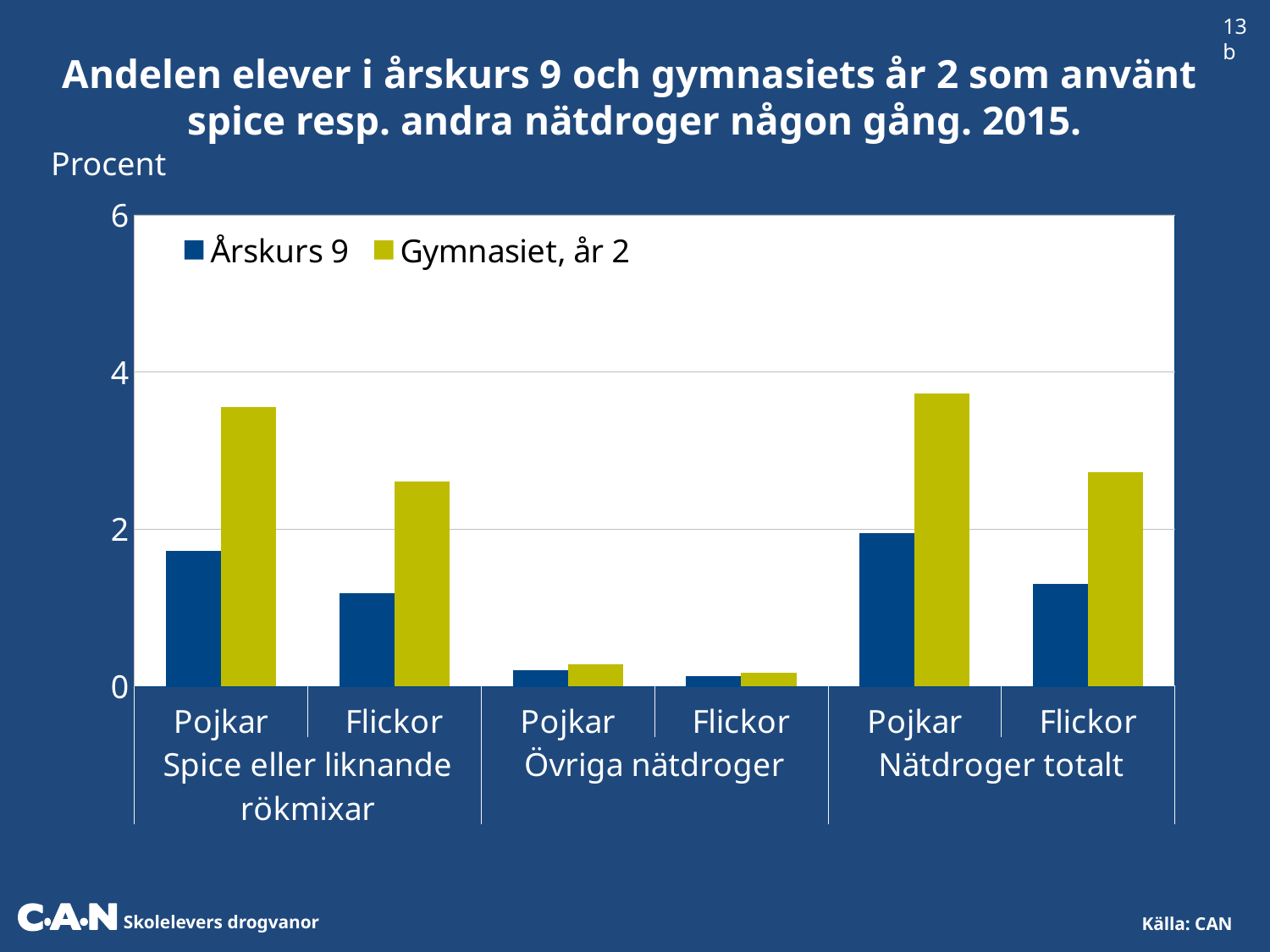
How many series does the legend list? 2 Is the value for Årskurs 9 Pojkar under Spice eller liknande rökmixar greater or less than 2? less For Pojkar under Spice eller liknande rökmixar, which series has the larger value, Årskurs 9 or Gymnasiet, år 2? Gymnasiet, år 2 What kind of chart is shown on the slide? bar chart What are the two series named in the legend? Årskurs 9 and Gymnasiet, år 2 How many main drug groups are shown along the x axis? 3 Which bar is the highest in the chart? Gymnasiet, år 2, Pojkar, Nätdroger totalt Is the value for Gymnasiet, år 2 Flickor under Nätdroger totalt greater or less than 2? greater Is the value for Gymnasiet, år 2 Pojkar under Spice eller liknande rökmixar greater or less than 2? greater What unit is shown on the vertical axis label? Procent Which bar is the lowest in the chart? Årskurs 9, Flickor, Övriga nätdroger